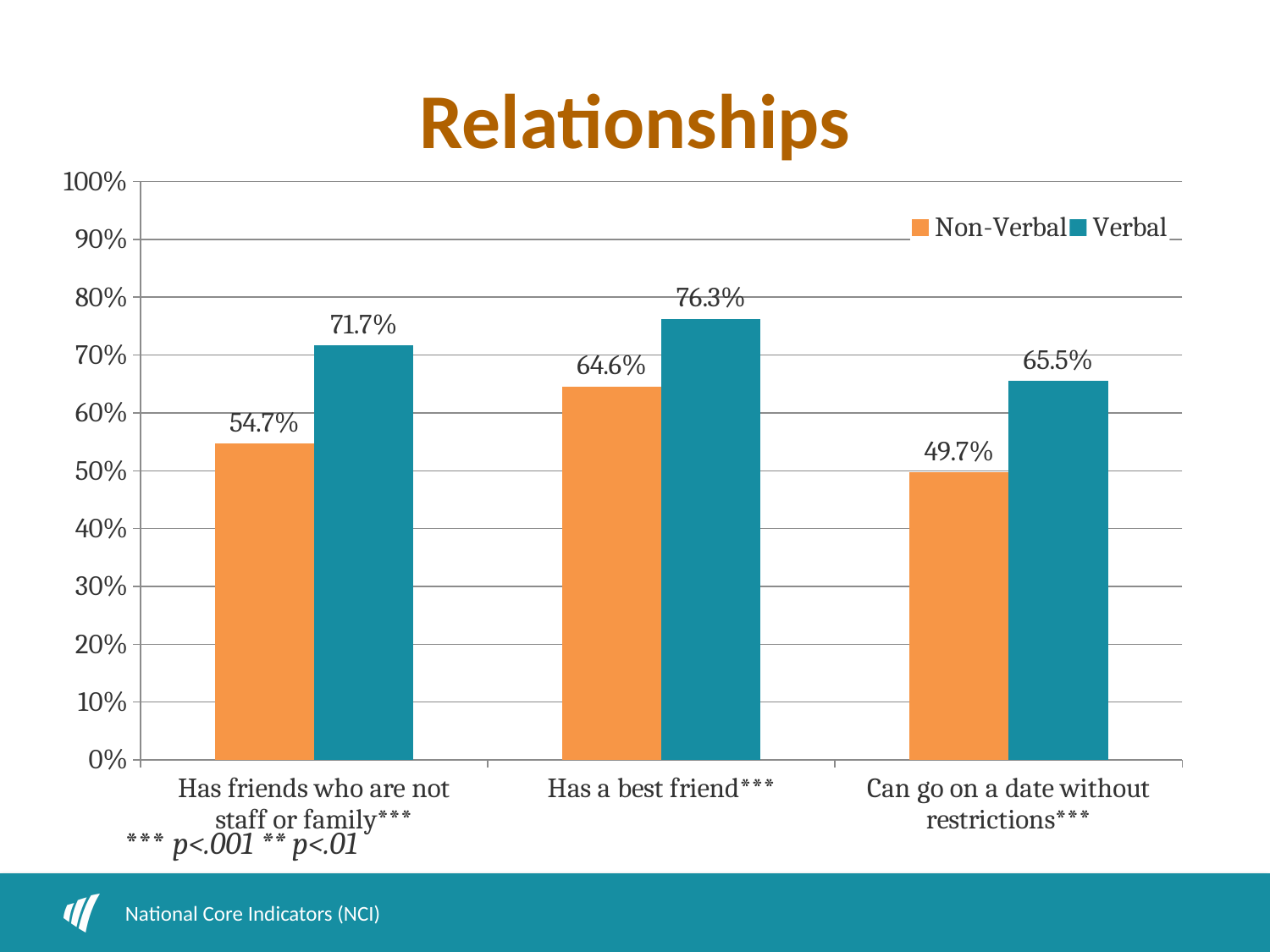
What kind of chart is shown on the slide? Bar chart What is the Non-Verbal value for "Can go on a date without restrictions"? 49.7% Which category has the lowest Non-Verbal value? Can go on a date without restrictions What is the Verbal value for "Has a best friend"? 76.3% What is the difference between the Verbal and Non-Verbal values for "Has friends who are not staff or family"? 17.0% How many series does the legend list? 2 Which is larger for "Has a best friend": the Non-Verbal value or the Verbal value? Verbal Is the Non-Verbal value for "Has a best friend" greater or less than 60%? greater How many categories are shown on the x axis? 3 What is the Non-Verbal value for "Has friends who are not staff or family"? 54.7% What is the Verbal value for "Can go on a date without restrictions"? 65.5% Which category has the highest Verbal value? Has a best friend